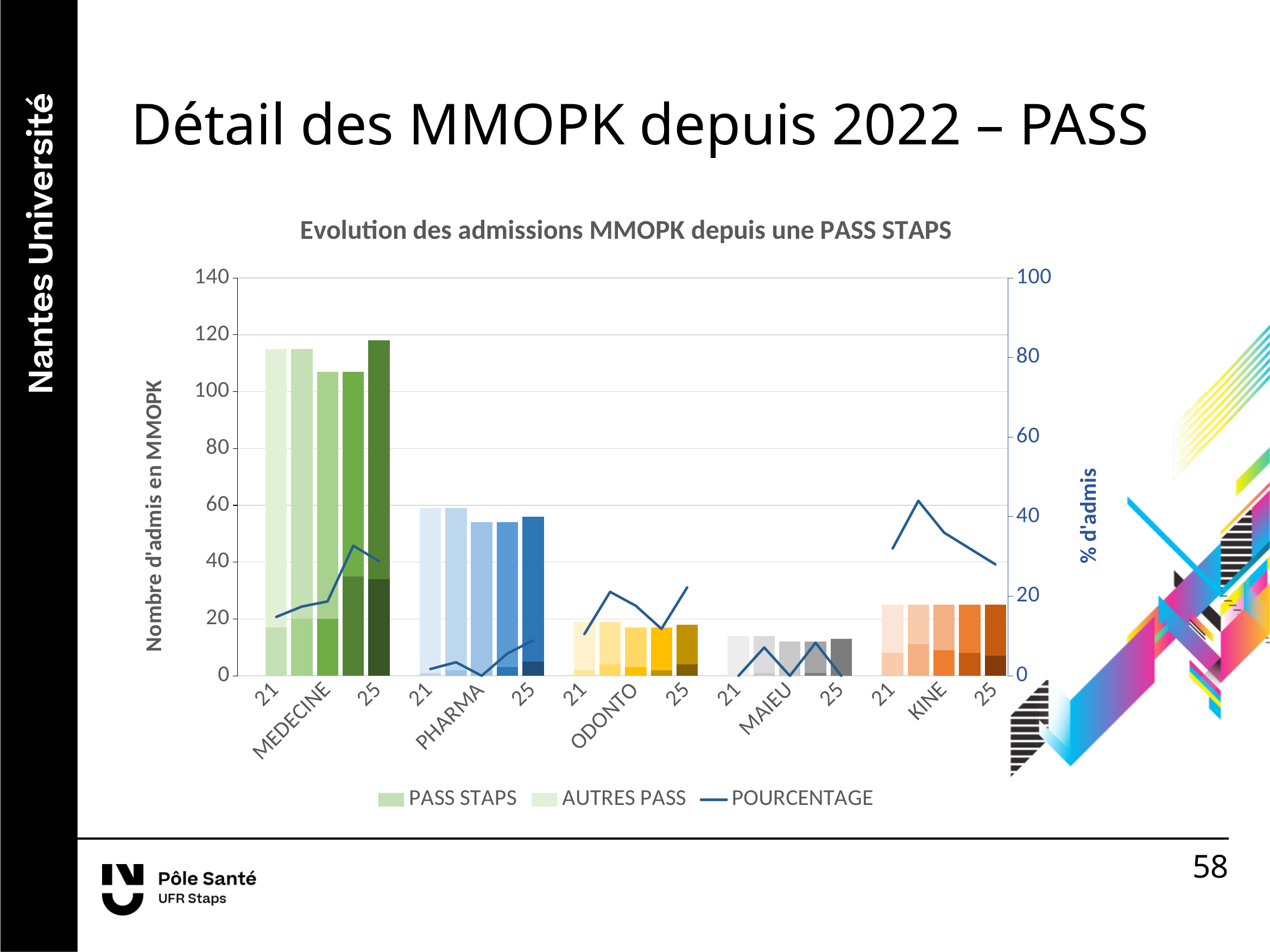
How many series does the legend list? 3 Which is larger, the total stacked bar for MEDECINE in 25 or for PHARMA in 25? MEDECINE in 25 Which discipline has the tallest stacked bars? MEDECINE What is the label of the left vertical axis? Nombre d'admis en MMOPK What kind of chart is shown on the slide? Bar chart with a line Is the total stacked bar for MAIEU in 21 greater or less than 20? less What are the three entries in the chart legend? PASS STAPS, AUTRES PASS, POURCENTAGE Is the total stacked bar for ODONTO in 21 greater or less than 40? less Does the POURCENTAGE line for KINE rise or fall from 22 to 25? fall Is the total stacked bar for MEDECINE in 25 greater or less than 100? greater Which discipline has the shortest stacked bars? MAIEU How many disciplines are shown along the x axis? 5